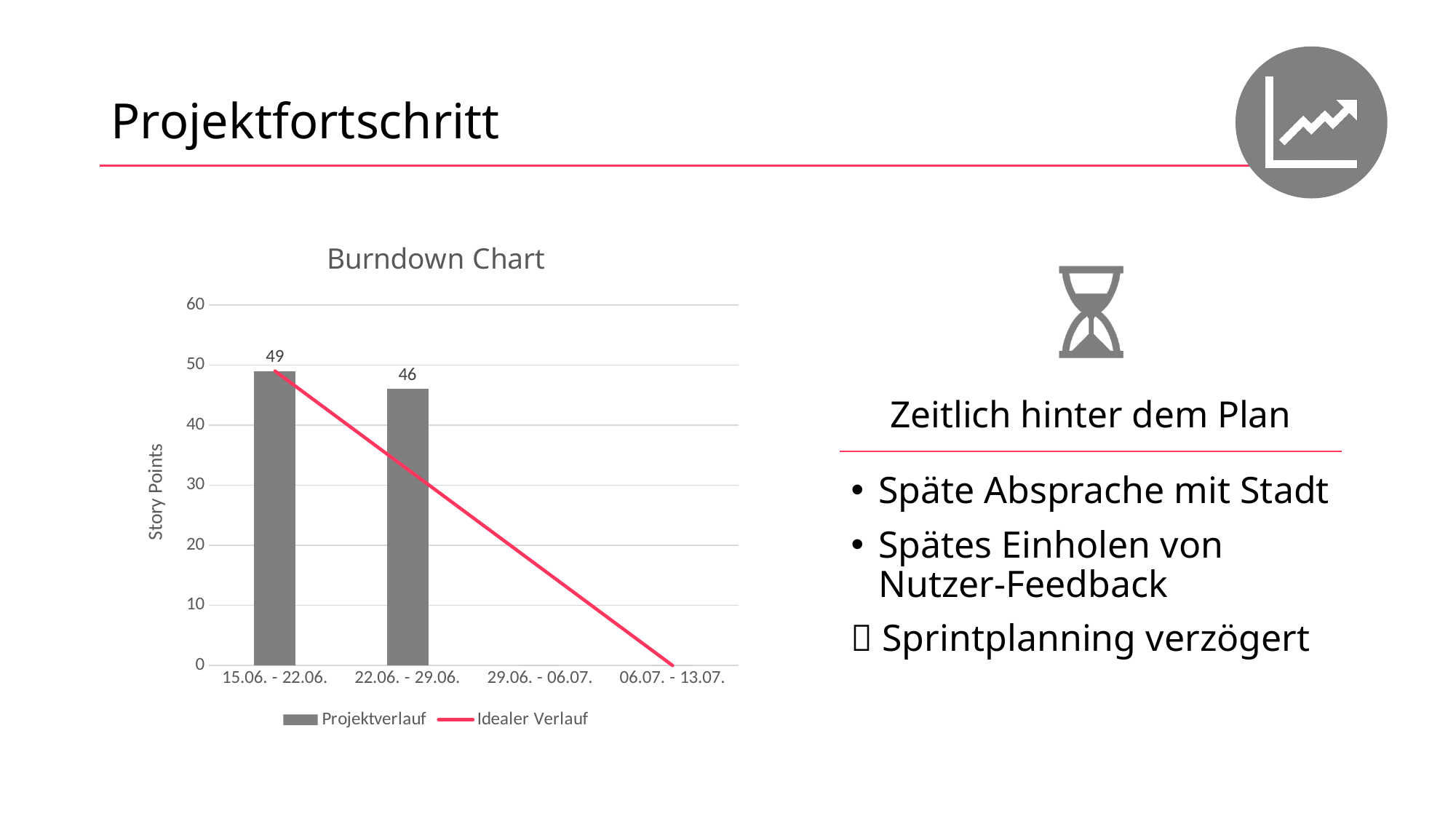
Does the Idealer Verlauf line rise or fall along the x axis? fall How many series does the legend list? 2 What is the title of the chart? Burndown Chart How many periods are shown on the x axis? 4 What is the Projektverlauf value for 22.06. - 29.06.? 46 Which is larger, the Projektverlauf value for 15.06. - 22.06. or for 22.06. - 29.06.? 15.06. - 22.06. What is the label of the y axis? Story Points Which period has the highest Projektverlauf bar? 15.06. - 22.06. What is the Projektverlauf value for 15.06. - 22.06.? 49 Is the Idealer Verlauf value for 22.06. - 29.06. greater or less than 40? less Is the Idealer Verlauf value for 29.06. - 06.07. greater or less than 10? greater What is the difference between the Projektverlauf values for 15.06. - 22.06. and 22.06. - 29.06.? 3